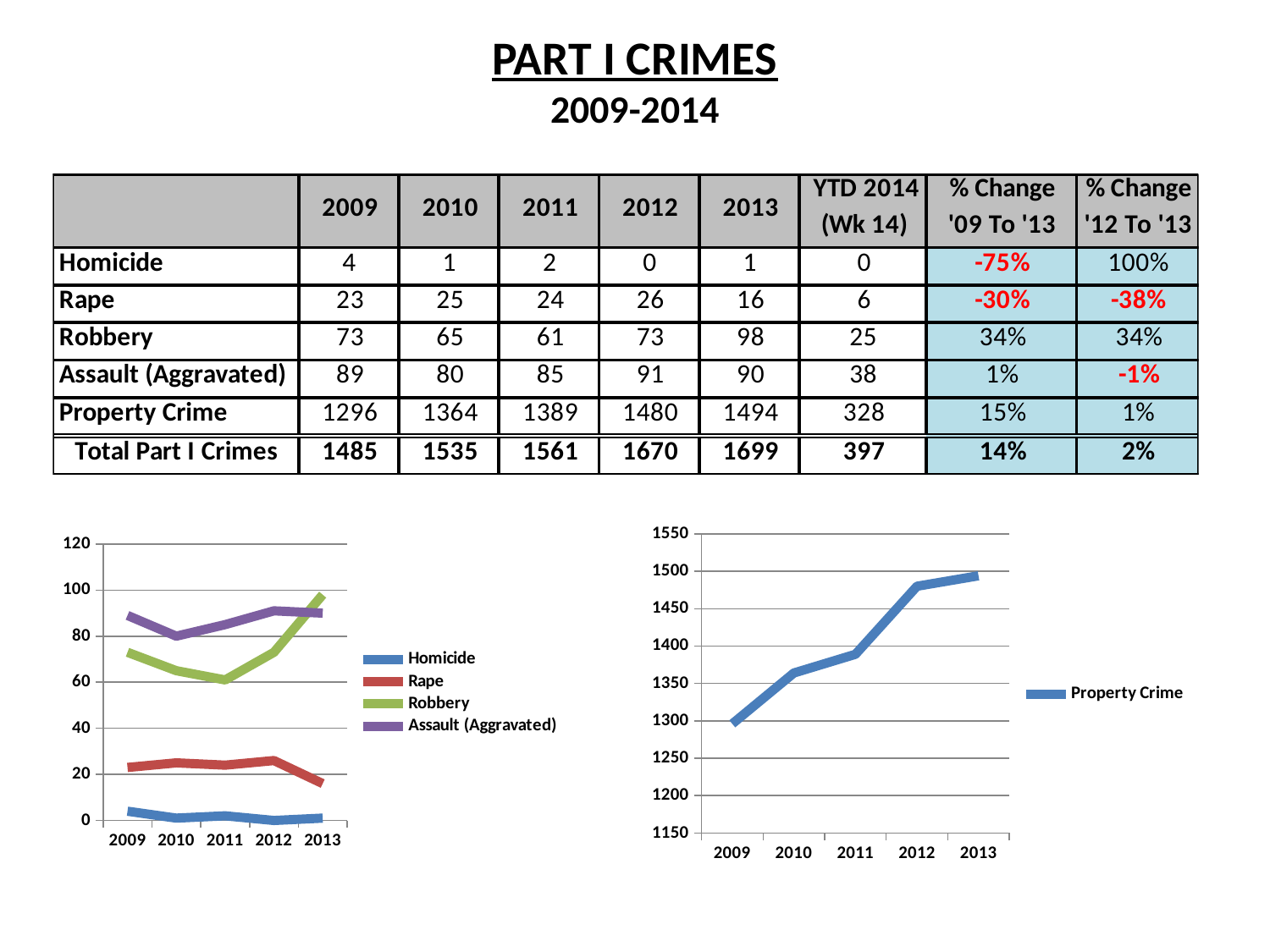
In the left chart, which is larger in 2009, Robbery or Assault (Aggravated)? Assault (Aggravated) How many years are shown along the x axis of the right chart (Property Crime)? 5 In the right chart (Property Crime), do the values rise or fall from 2009 to 2013? rise In the right chart (Property Crime), is the value for 2013 greater or less than 1450? greater How many series does the legend of the left chart list? 4 In the left chart, is the Robbery value for 2011 greater or less than 80? less What kind of chart is the left chart on the slide? line chart In the right chart (Property Crime), is the value for 2009 greater or less than 1350? less In the left chart, in which year is the Robbery series at its lowest? 2011 What is the Property Crime value for 2012 plotted in the right chart? 1480 In the left chart's legend, what colour represents Rape? red In the left chart, which series has the highest value in 2013? Robbery